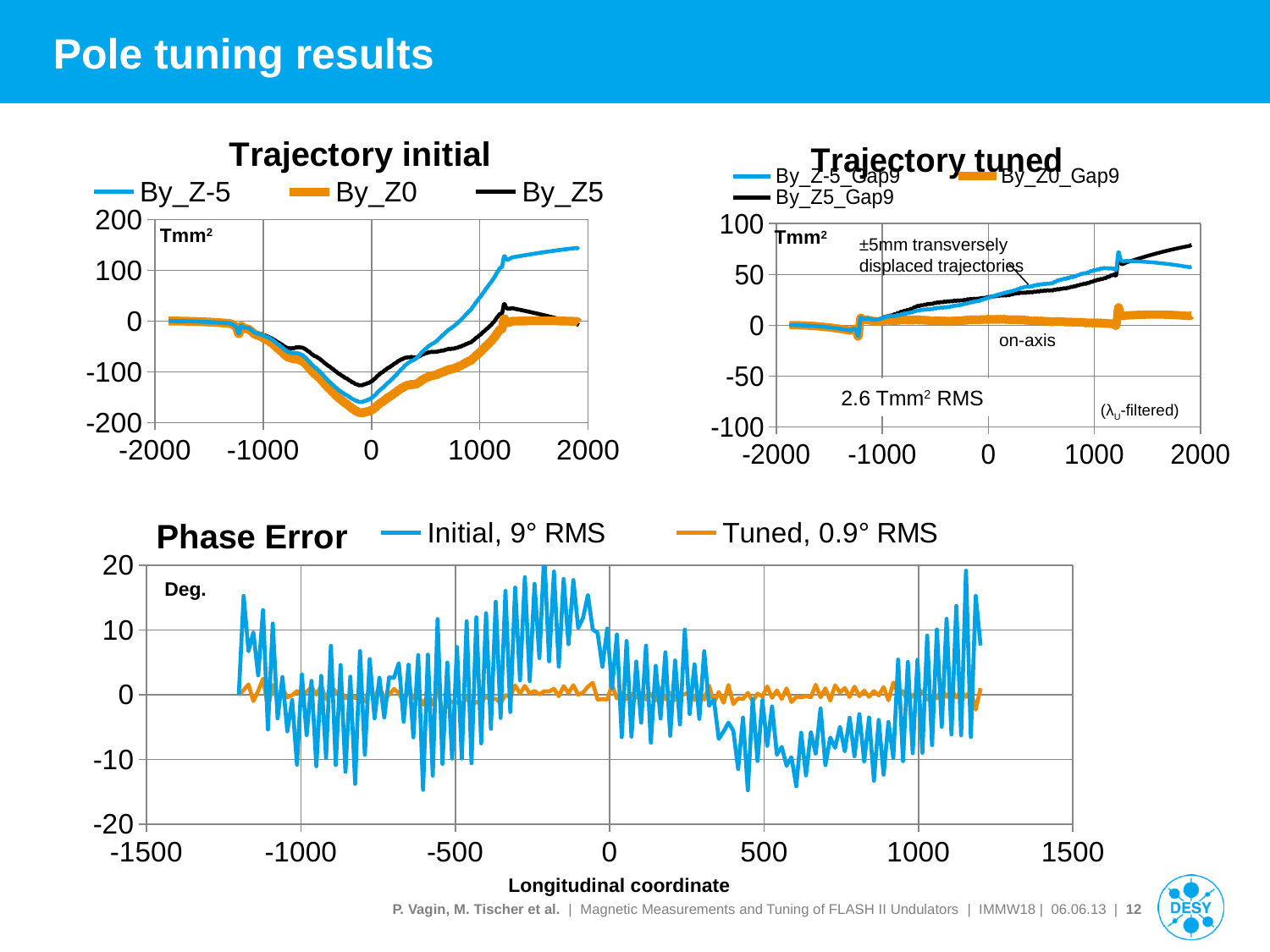
How many series does the legend of the "Phase Error" chart list? 2 In the "Trajectory tuned" chart, does By_Z5_Gap9 rise or fall from x = -1000 to x = 2000? rises In the "Trajectory initial" chart, which series reaches the lowest value near x = 0? By_Z0 How many series does the legend of the "Trajectory tuned" chart list? 3 What kind of chart is the "Trajectory initial" chart? line chart In the "Trajectory initial" chart, is the value of By_Z-5 at the right end of the x axis (near 2000) greater or less than 100? greater In the "Phase Error" chart, is the largest value of the Tuned series greater or less than 10? less How many series does the legend of the "Trajectory initial" chart list? 3 In the "Trajectory initial" chart, at the right end of the x axis, which is larger: By_Z-5 or By_Z0? By_Z-5 What RMS value does the legend of the "Phase Error" chart give for the Tuned series? 0.9° RMS In the "Trajectory initial" chart, is the lowest value of By_Z0 greater or less than -100? less